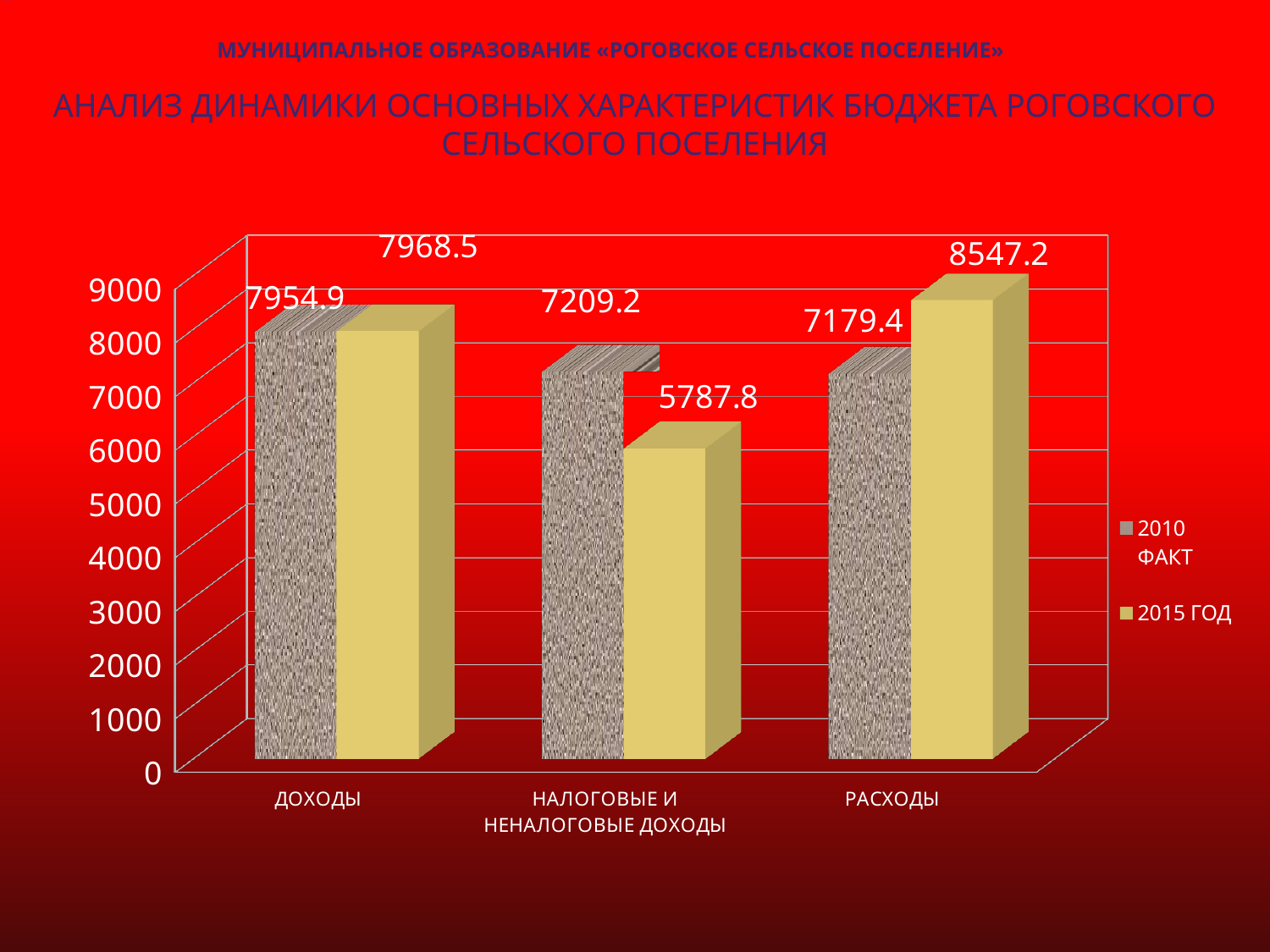
How many categories are shown on the x axis? 3 Which category has the highest value in the 2015 ГОД series? РАСХОДЫ What is the value for ДОХОДЫ in the 2010 ФАКТ series? 7954.9 What is the value for ДОХОДЫ in the 2015 ГОД series? 7968.5 What is the value for РАСХОДЫ in the 2010 ФАКТ series? 7179.4 What kind of chart is shown on the slide? bar chart What is the value for НАЛОГОВЫЕ И НЕНАЛОГОВЫЕ ДОХОДЫ in the 2015 ГОД series? 5787.8 Which category has the lowest value in the 2015 ГОД series? НАЛОГОВЫЕ И НЕНАЛОГОВЫЕ ДОХОДЫ How many series does the legend list? 2 What is the difference between the 2015 ГОД and 2010 ФАКТ values for РАСХОДЫ? 1367.8 Is the 2015 ГОД value for РАСХОДЫ greater or less than 8000? greater For НАЛОГОВЫЕ И НЕНАЛОГОВЫЕ ДОХОДЫ, which series has the larger value, 2010 ФАКТ or 2015 ГОД? 2010 ФАКТ